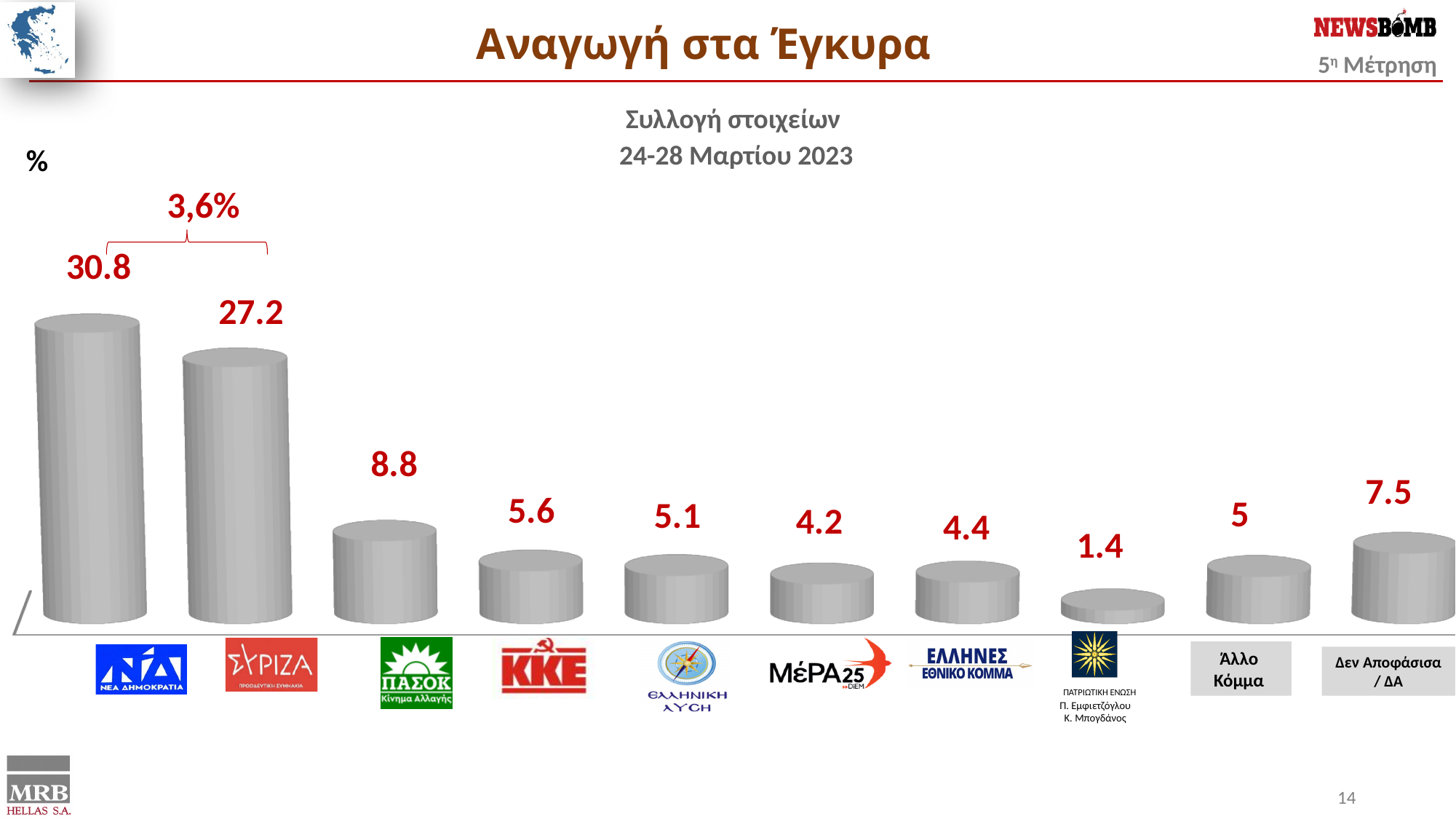
What is the value for ΝΕΑ ΔΗΜΟΚΡΑΤΙΑ? 30.8 What kind of chart is shown on the slide? Bar chart What is the value for ΣΥΡΙΖΑ? 27.2 What is the difference between the values for ΝΕΑ ΔΗΜΟΚΡΑΤΙΑ and ΣΥΡΙΖΑ, as annotated on the chart? 3,6% Which category has the highest value? ΝΕΑ ΔΗΜΟΚΡΑΤΙΑ What is the value for ΚΚΕ? 5.6 What is the value for ΠΑΣΟΚ? 8.8 Which category has the lowest value? ΠΑΤΡΙΩΤΙΚΗ ΕΝΩΣΗ What is the value for Δεν Αποφάσισα / ΔΑ? 7.5 Which is larger, the value for ΕΛΛΗΝΕΣ or the value for ΜέΡΑ25? ΕΛΛΗΝΕΣ What is the title of the slide? Αναγωγή στα Έγκυρα How many categories are shown in the chart? 10